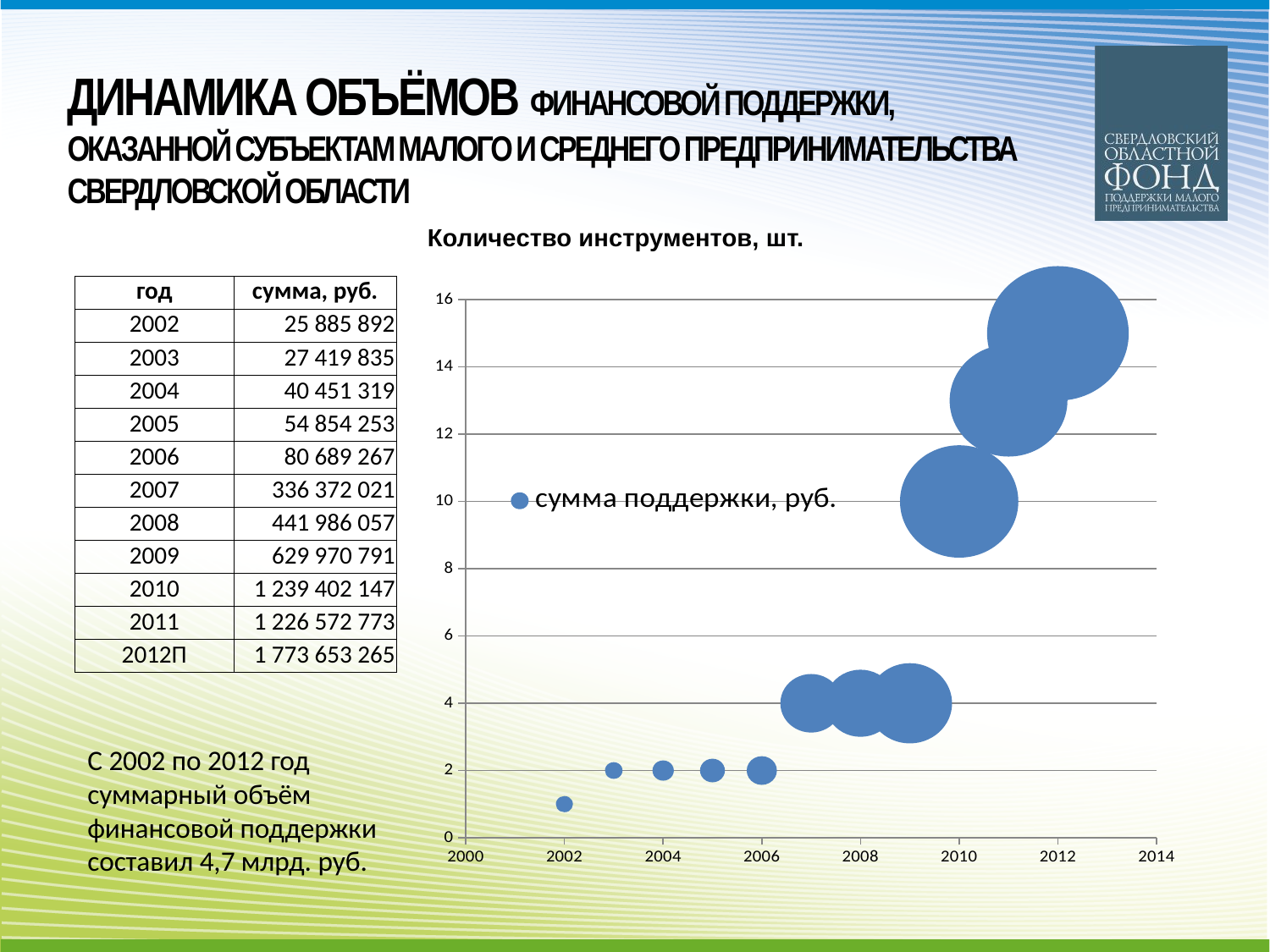
Do the values rise or fall as the years increase along the x axis? rise How many bubbles (data points) are plotted in the chart? 11 Which year has the highest number of instruments in the chart? 2012 What is the number of instruments (y value) for the year 2007? 4 What is the number of instruments (y value) for the year 2010? 10 Is the y value for 2002 greater or less than 2? less What is the title of the chart? Количество инструментов, шт. What is the number of instruments (y value) for the year 2004? 2 What kind of chart is shown on the slide? bubble chart How many series does the chart legend list? 1 Is the y value for 2012 greater or less than 14? greater What is the legend entry of the series plotted in the chart? сумма поддержки, руб.